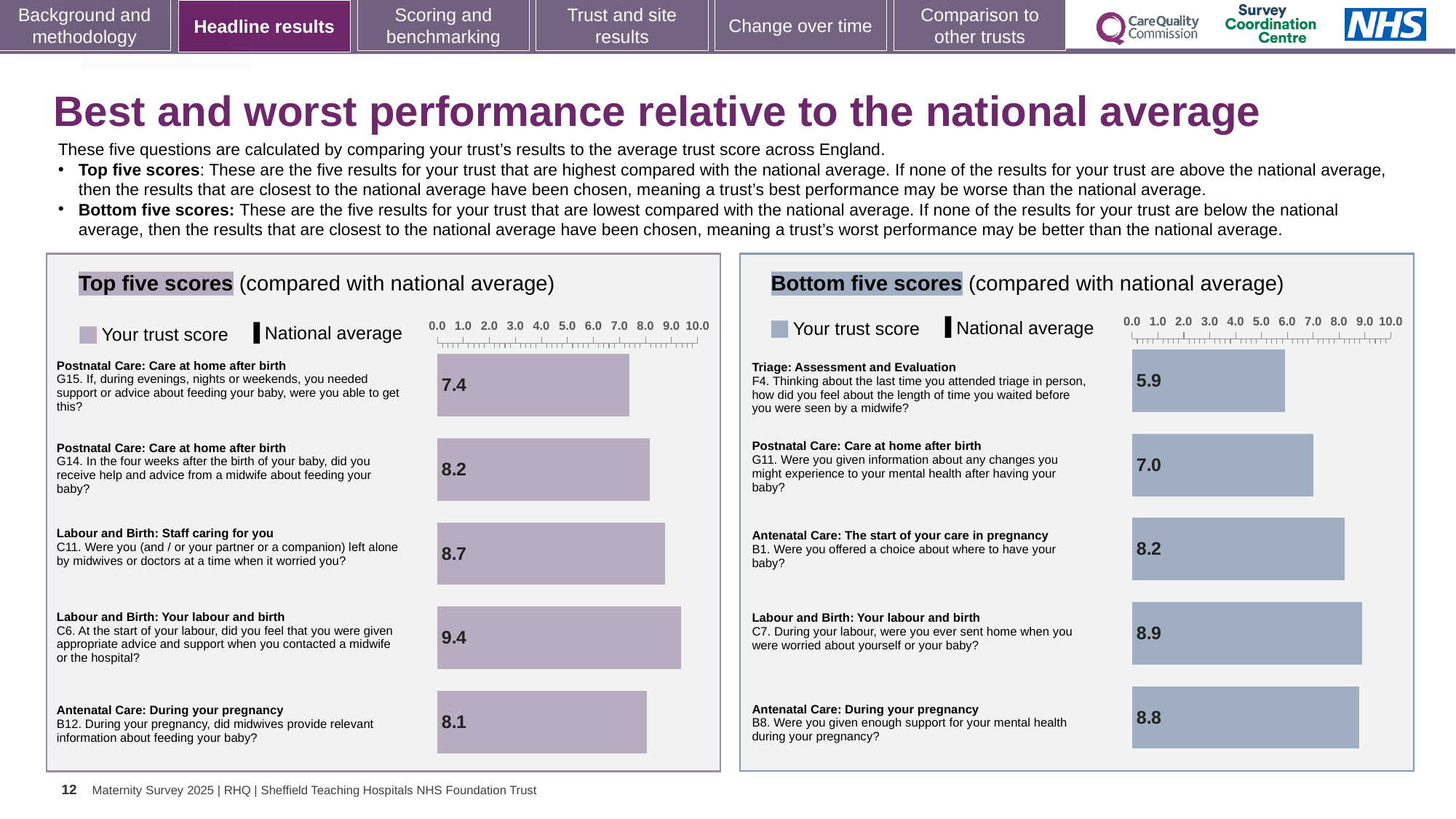
In the Bottom five scores chart, what is the trust score for question F4 about the length of time waited in triage before being seen by a midwife? 5.9 In the Bottom five scores chart, which question has the lowest trust score? F4 How many series does the legend of the Top five scores chart list? 2 In the Bottom five scores chart, what is the trust score for question G11 about information on changes to your mental health after having your baby? 7.0 In the Top five scores chart, which question has the lowest trust score? G15 How many bars are shown in the Bottom five scores chart? 5 In the Top five scores chart, what is the trust score for question G15 about support or advice on feeding your baby during evenings, nights or weekends? 7.4 In the Top five scores chart, what is the difference between the trust scores for C6 and G15? 2.0 In the Top five scores chart, which question has the highest trust score? C6 In the Top five scores chart, what is the trust score for question C6 about advice and support when you contacted a midwife or the hospital at the start of labour? 9.4 What type of chart is used for the Top five scores? Bar chart In the Bottom five scores chart, which has the larger trust score, B1 or G11? B1